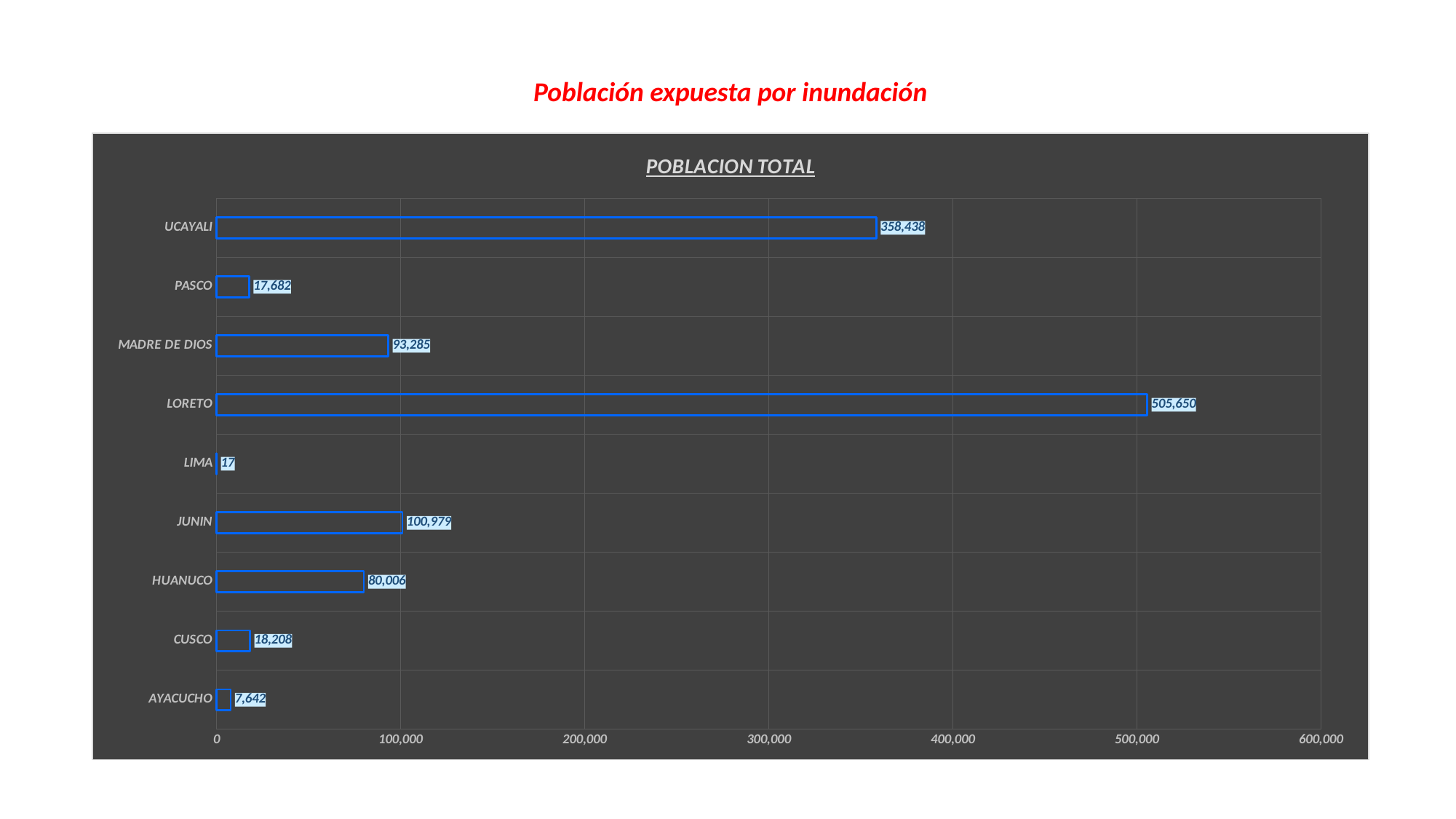
Which category has the lowest value? LIMA What is the value for LIMA? 17 How many categories are shown in the chart? 9 Which category has the highest value? LORETO What is the title of the chart? POBLACION TOTAL What is the value for JUNIN? 100,979 What kind of chart is shown? bar chart What is the difference between the values for LORETO and UCAYALI? 147,212 What is the value for LORETO? 505,650 Which is larger, the value for MADRE DE DIOS or the value for HUANUCO? MADRE DE DIOS Is the value for JUNIN greater or less than 100,000? greater What is the value for UCAYALI? 358,438